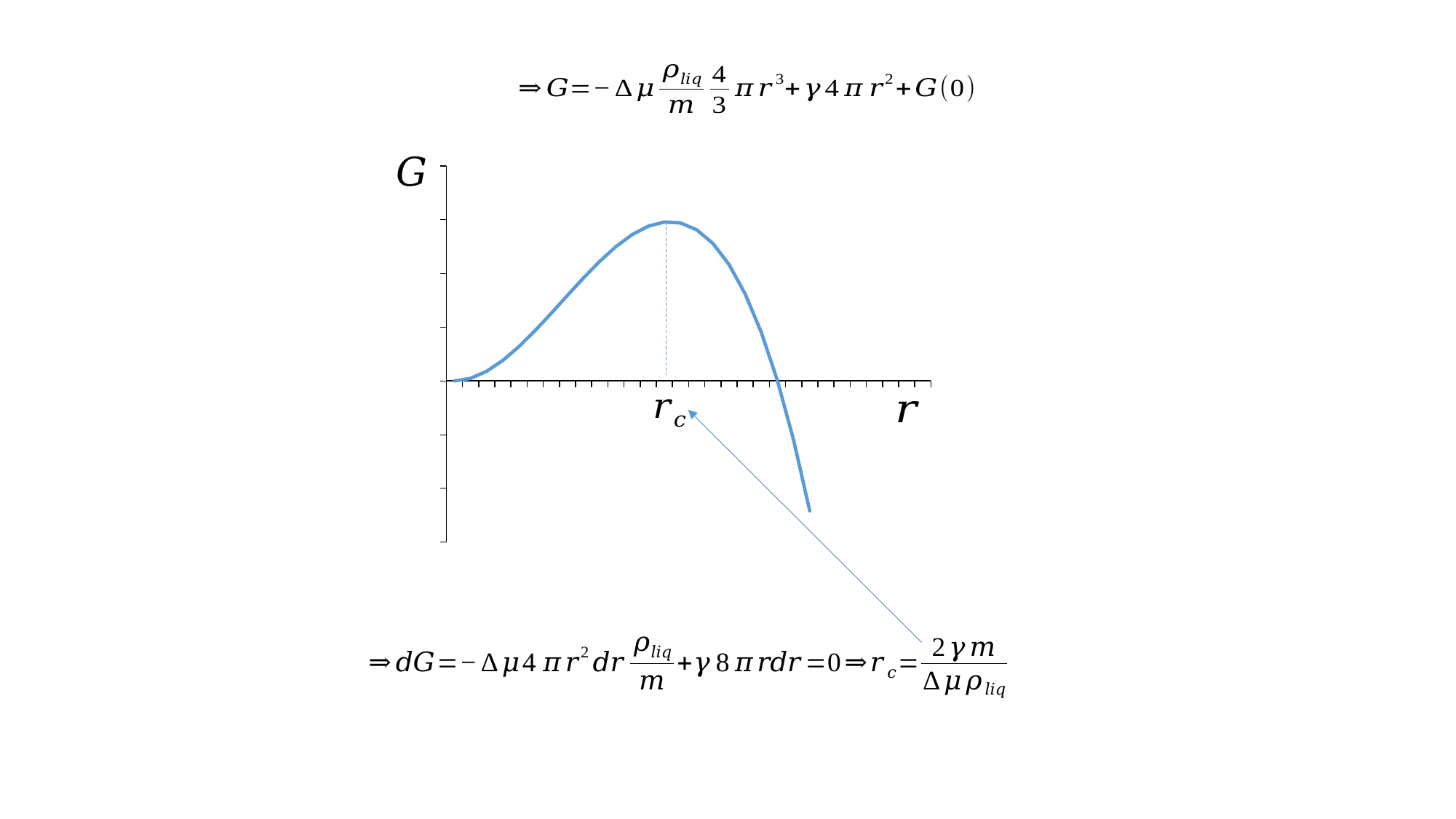
What is the label on the vertical axis of the chart? G Does the curve rise or fall as r increases beyond r_c? fall At which labelled value of r does the curve reach its maximum? r_c Is the value of G at r_c greater or less than zero? greater Does the curve rise or fall as r increases from zero up to r_c? rise Is the value of G at r_c greater or less than the value of G at the right end of the curve? greater How many curves are plotted on the chart? 1 What kind of chart is shown on the slide? line chart Does the curve end above or below the horizontal axis at its right end? below What is the label on the horizontal axis of the chart? r